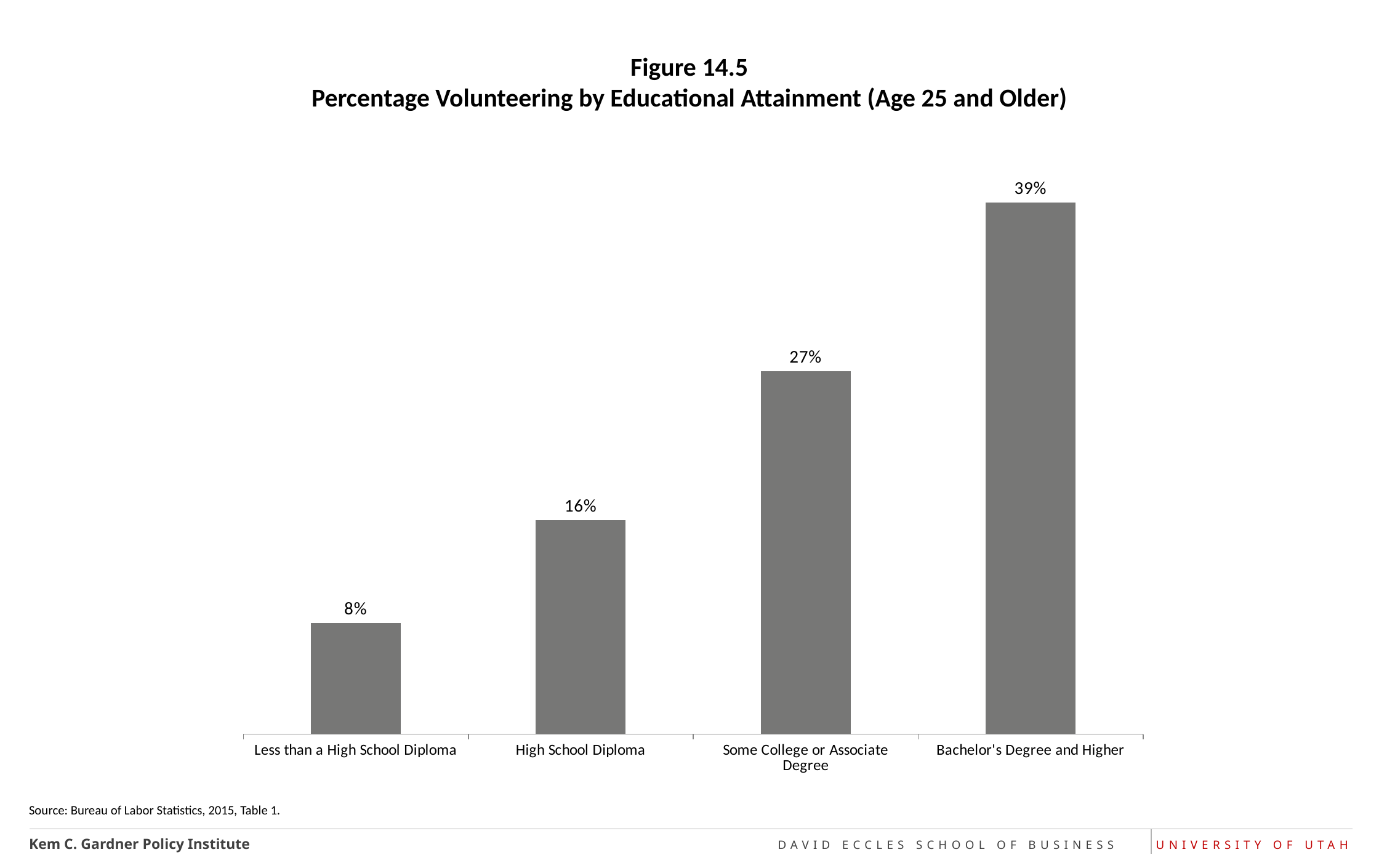
Which educational attainment category has the lowest percentage volunteering? Less than a High School Diploma How many educational attainment categories are shown in the chart? 4 Which has a higher percentage volunteering: High School Diploma or Some College or Associate Degree? Some College or Associate Degree What is the percentage volunteering for people with a High School Diploma? 16% Do the percentages rise or fall as educational attainment increases from left to right? Rise What is the percentage volunteering for people with Less than a High School Diploma? 8% What is the difference in percentage volunteering between Some College or Associate Degree and High School Diploma? 11% What is the percentage volunteering for people with Some College or Associate Degree? 27% What is the percentage volunteering for people with a Bachelor's Degree and Higher? 39% Which educational attainment category has the highest percentage volunteering? Bachelor's Degree and Higher What is the difference in percentage volunteering between Bachelor's Degree and Higher and Less than a High School Diploma? 31% What kind of chart is shown on the slide? Bar chart